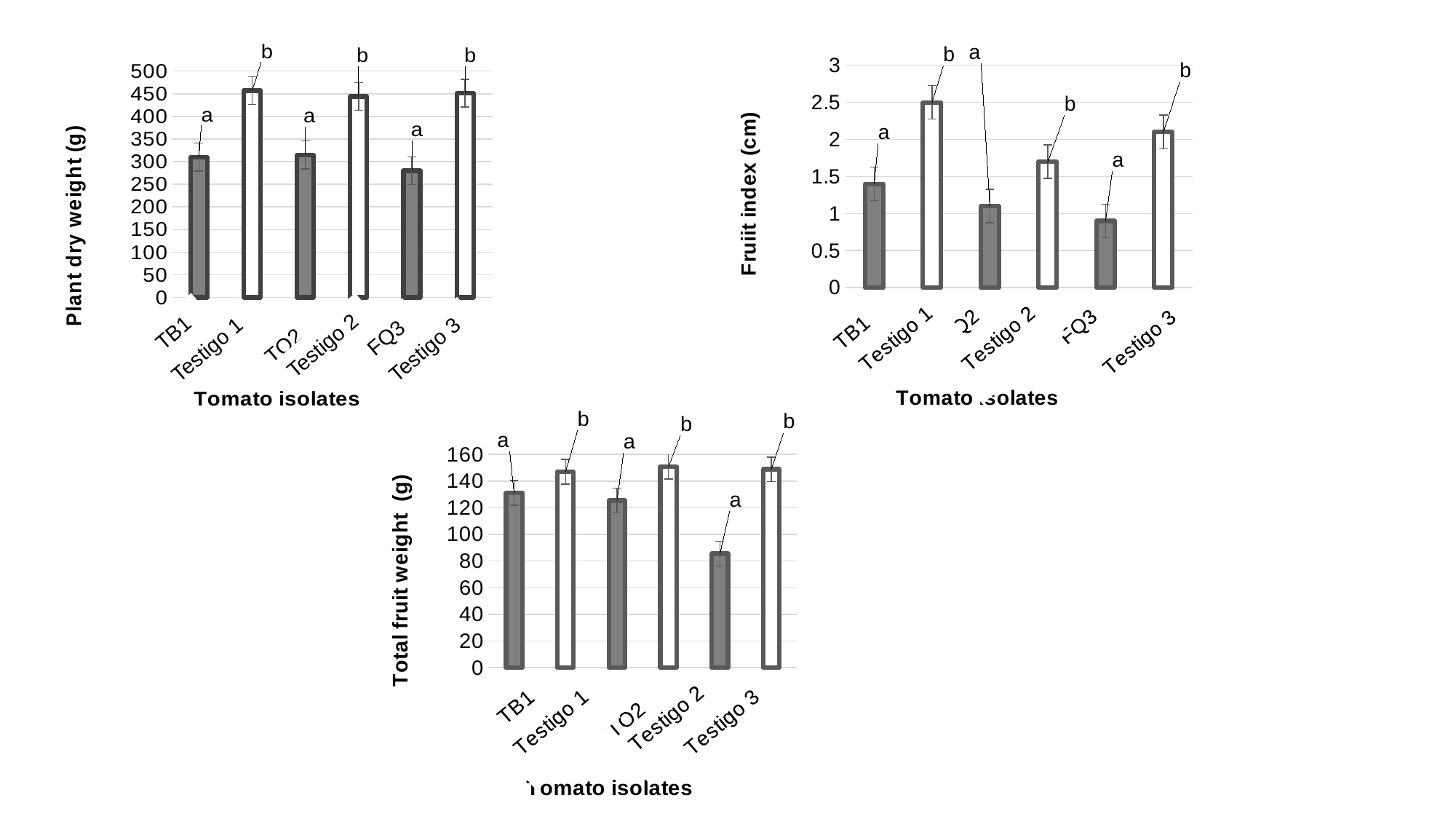
In the Fruit index (cm) chart, which category has the highest value? Testigo 1 In the Total fruit weight (g) chart, is the value for TB1 greater or less than 120? greater In the Plant dry weight (g) chart, is the value for FQ3 greater or less than 300? less What is the x-axis label of the Plant dry weight (g) chart? Tomato isolates How many bars are plotted in the Plant dry weight (g) chart? 6 In the Plant dry weight (g) chart, which is larger, the value for TB1 or the value for Testigo 1? Testigo 1 What kind of chart is the Total fruit weight (g) chart? bar chart In the Fruit index (cm) chart, is the value for Testigo 2 greater or less than 1.5? greater In the Plant dry weight (g) chart, which category has the lowest value? FQ3